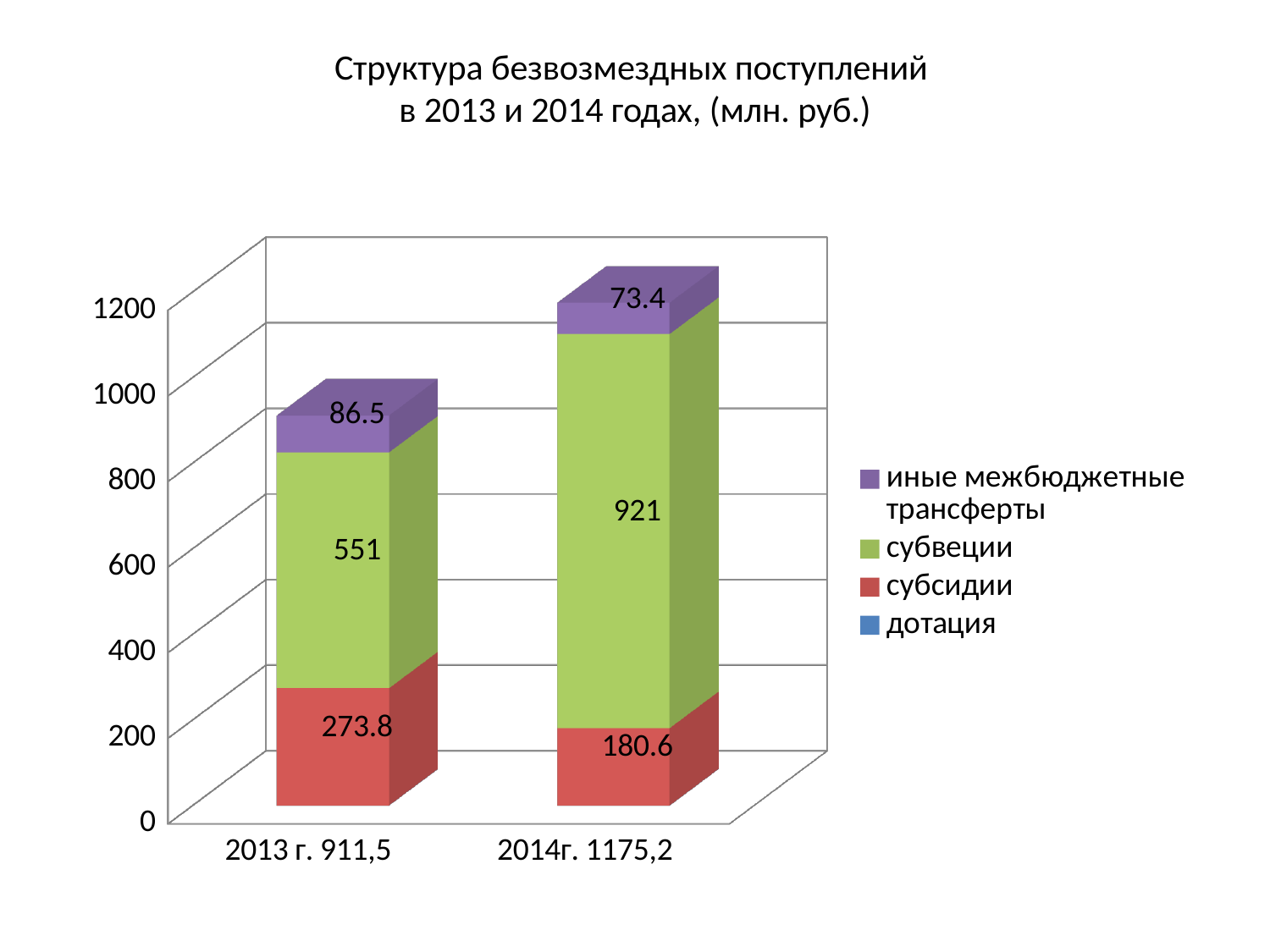
What type of chart is shown on the slide? stacked bar chart What is the difference between the субсидии values for 2013 г. and 2014г.? 93.2 What is the value of субсидии for 2013 г.? 273.8 What is the difference between the субвеции values for 2014г. and 2013 г.? 370 What is the value of субсидии for 2014г.? 180.6 What is the value of иные межбюджетные трансферты for 2014г.? 73.4 Which year has the larger value for субвеции, 2013 г. or 2014г.? 2014г. How many series does the legend list? 4 Which series is shown in green in the legend? субвеции What is the value of субвеции for 2014г.? 921 What is the value of иные межбюджетные трансферты for 2013 г.? 86.5 How many categories (years) are shown on the x axis? 2